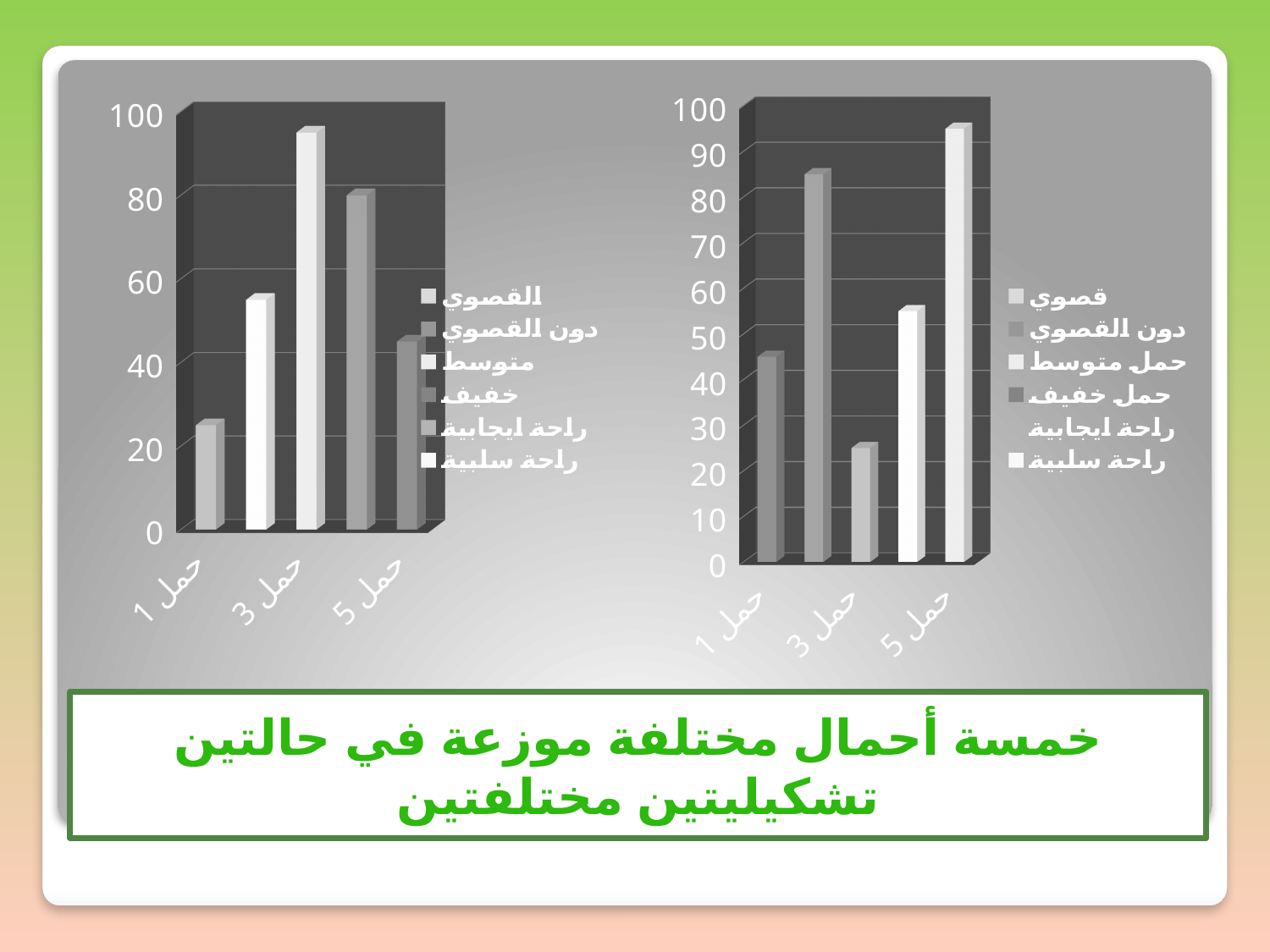
What is the first legend entry of the right chart? قصوي In the left chart, which labelled category has the shortest bar? حمل 1 In the left chart, which labelled category has the tallest bar? حمل 3 How many bars are plotted in the chart on the right side of the slide? 5 What kind of chart is the chart on the left side of the slide? bar chart In the right chart, which labelled category has the shortest bar? حمل 3 In the right chart, is the value for حمل 3 greater or less than 30? less In the left chart, is the value for حمل 1 greater or less than 40? less In the right chart, which labelled category has the tallest bar? حمل 5 In the right chart, which is larger, the value for حمل 1 or the value for حمل 3? حمل 1 In the left chart, is the value for حمل 3 greater or less than 80? greater How many series does the legend of the left chart list? 6